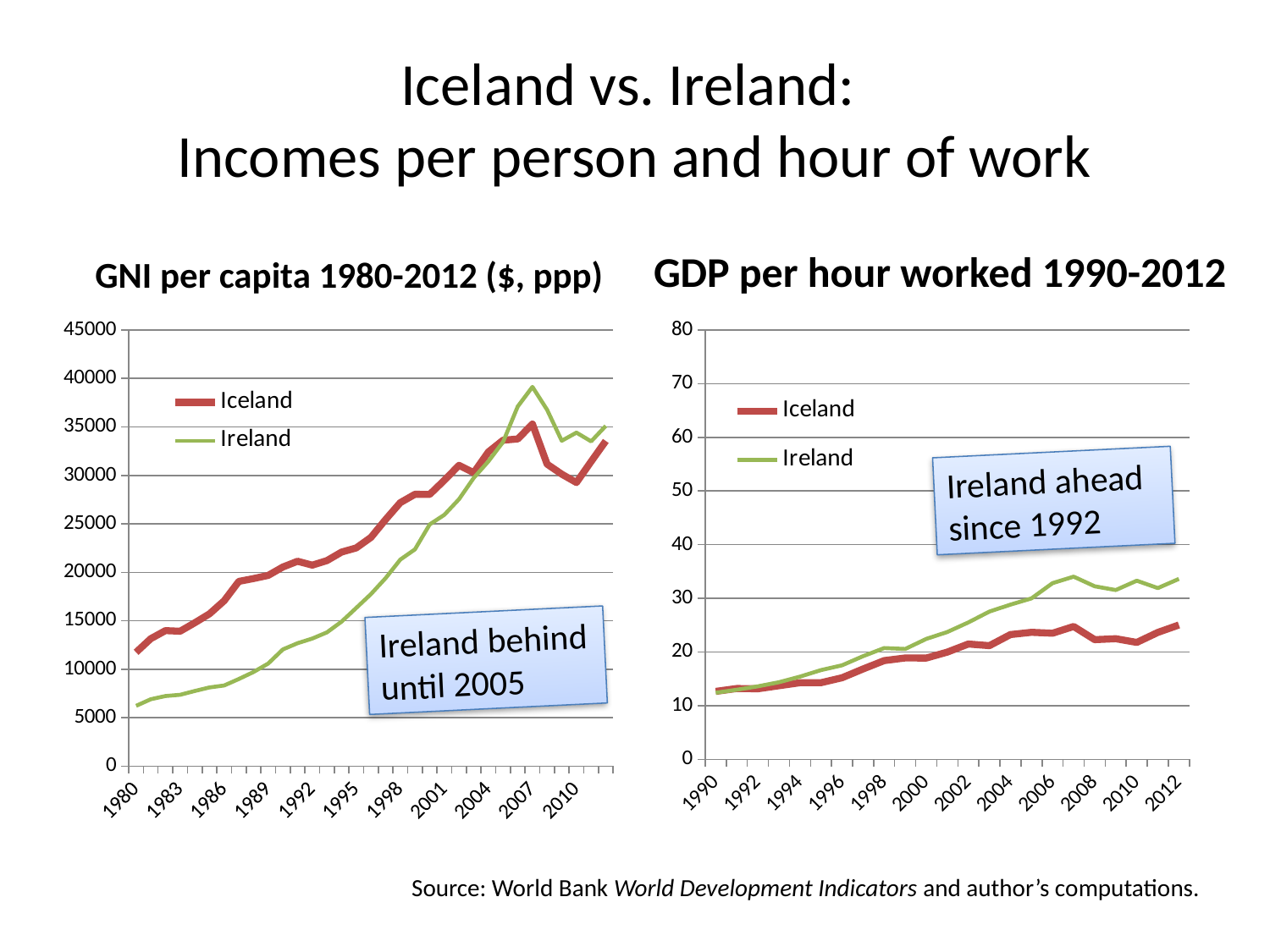
In the GNI per capita 1980-2012 chart, is the value for Ireland in 2007 greater or less than 35000? greater In the GDP per hour worked 1990-2012 chart, what colour is the Ireland line? green What kind of chart is the GNI per capita 1980-2012 chart on the left? line chart In the GDP per hour worked 1990-2012 chart, is the value for Ireland in 2007 greater or less than 30? greater In the GDP per hour worked 1990-2012 chart, is the value for Iceland in 2012 greater or less than 30? less How many series does the legend of the GDP per hour worked 1990-2012 chart list? 2 In the GNI per capita 1980-2012 chart, which country has the higher value in 1990, Iceland or Ireland? Iceland In the GDP per hour worked 1990-2012 chart, which country has the higher value in 2012, Iceland or Ireland? Ireland In the GNI per capita 1980-2012 chart, which country has the higher value in 2007, Iceland or Ireland? Ireland